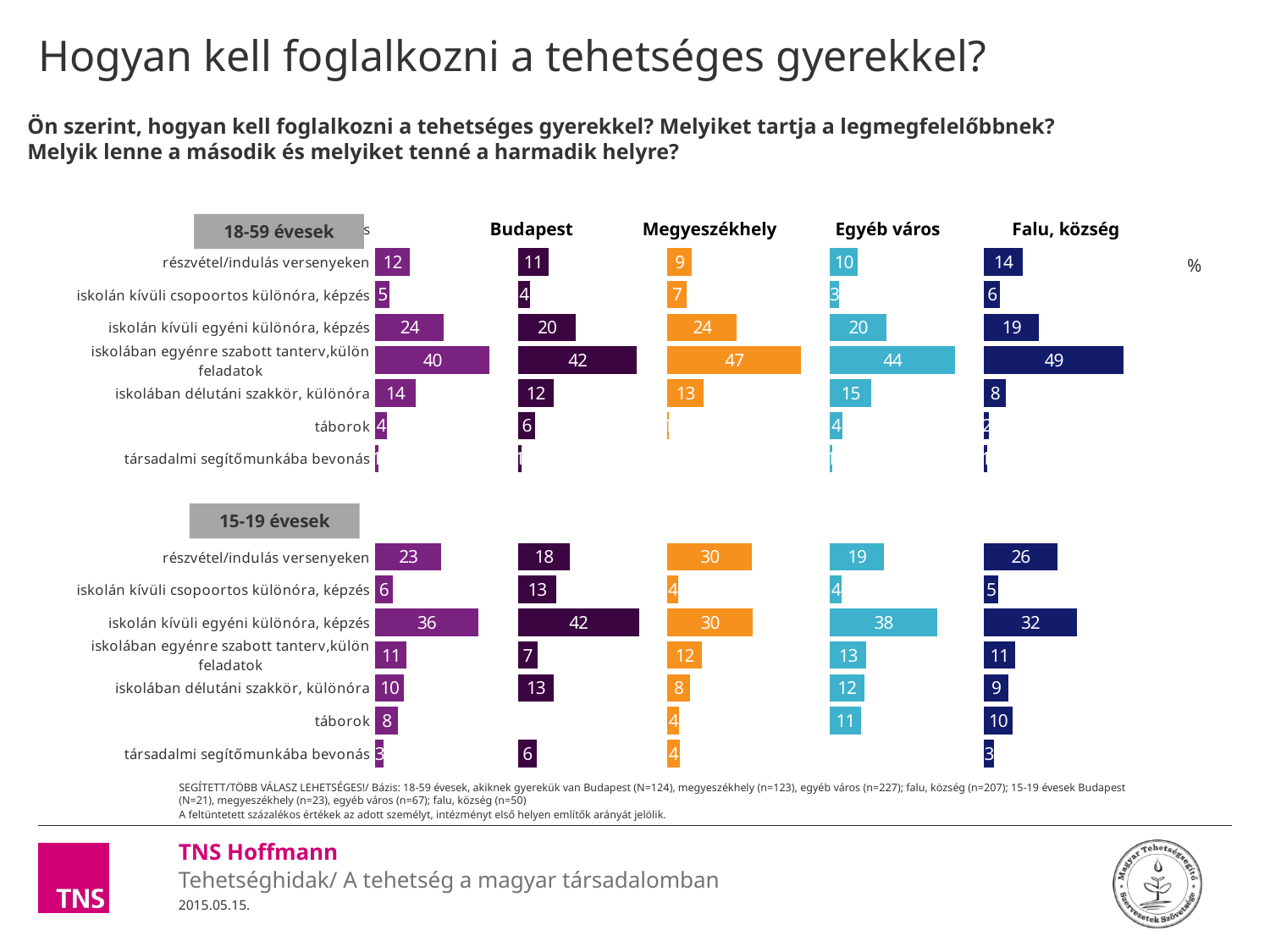
In the 15-19 évesek row, Megyeszékhely chart, what is the value for 'részvétel/indulás versenyeken'? 30 In the 15-19 évesek row, Egyéb város chart, what is the value for 'táborok'? 11 In the 18-59 évesek row, what is the difference between the Falu, község value (49) and the Budapest value (42) for 'iskolában egyénre szabott tanterv, külön feladatok'? 7 In the 18-59 évesek row, Budapest chart, what is the value for 'iskolában egyénre szabott tanterv, külön feladatok'? 42 What is the difference between the 15-19 évesek overall value (36) and the 18-59 évesek overall value (24) for 'iskolán kívüli egyéni különóra, képzés'? 12 In the 18-59 évesek row, Megyeszékhely chart, which category has the highest value? iskolában egyénre szabott tanterv, külön feladatok In the 15-19 évesek row, Budapest chart, which category has the highest value? iskolán kívüli egyéni különóra, képzés What type of chart is used on the slide? bar chart In the 15-19 évesek row, which is larger for 'iskolán kívüli egyéni különóra, képzés': the Egyéb város value or the Falu, község value? Egyéb város In the 18-59 évesek row, Egyéb város chart, what is the value for 'iskolában délutáni szakkör, különóra'? 15 In the 18-59 évesek row, Falu, község chart, what is the value for 'részvétel/indulás versenyeken'? 14 How many categories are listed in each chart on the slide? 7